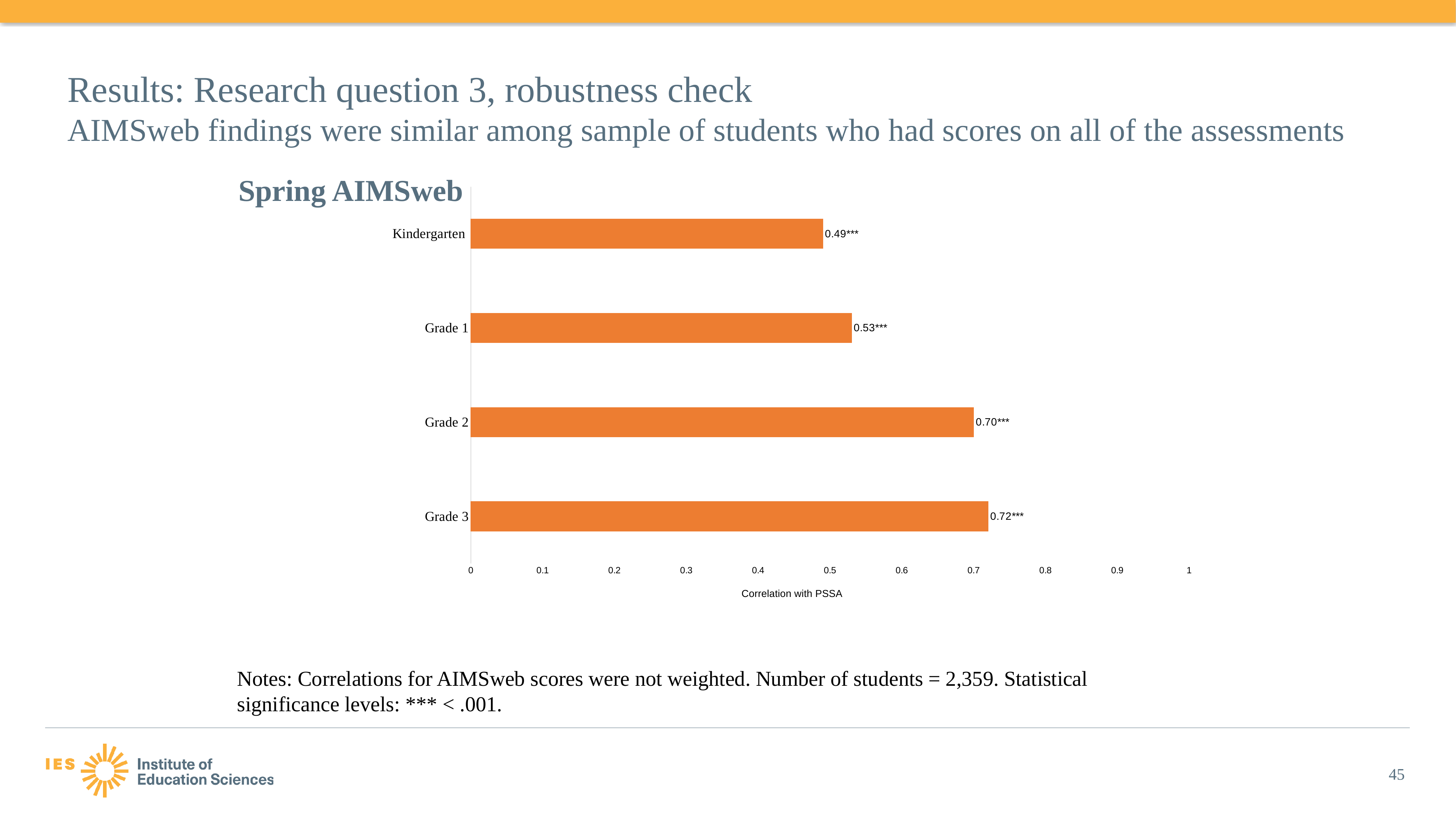
Which has a larger correlation with PSSA, Grade 1 or Grade 2? Grade 2 What is the title of the chart? Spring AIMSweb How many grade categories are shown in the chart? 4 What is the correlation with PSSA for Grade 2? 0.70*** What is the correlation with PSSA for Grade 1? 0.53*** What kind of chart is shown on the slide? Bar chart Which grade has the lowest correlation with PSSA? Kindergarten Is the value for Grade 3 greater or less than 0.6? greater Which grade has the highest correlation with PSSA? Grade 3 What is the correlation with PSSA for Kindergarten? 0.49*** What is the correlation with PSSA for Grade 3? 0.72*** What is the difference between the Grade 2 and Kindergarten correlations? 0.21